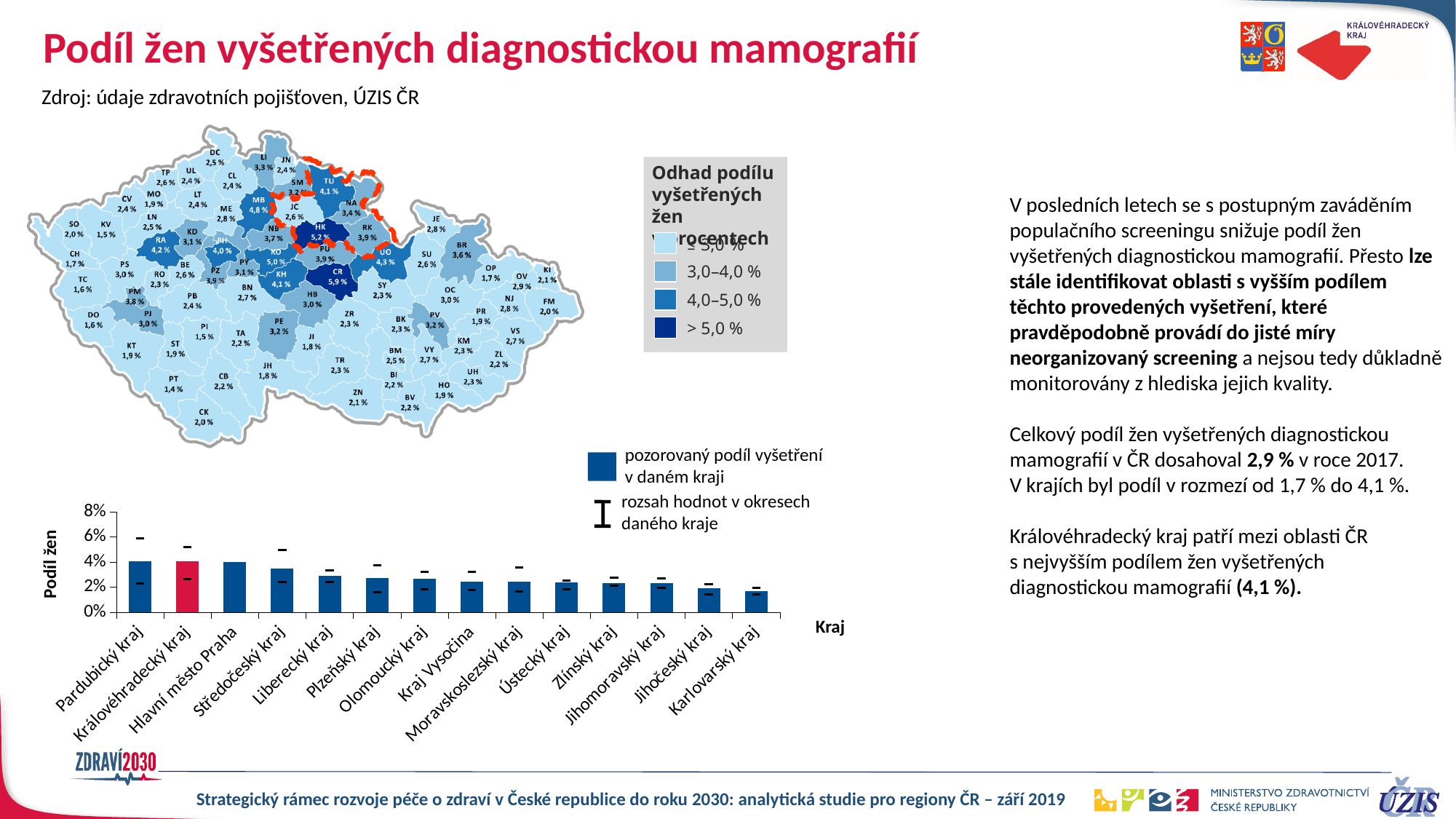
On the map chart, what is the difference between the values for CR and HK? 0,7 % In the bar chart at the bottom left, how many regions (kraje) are plotted on the x axis? 14 On the map chart, what value is shown for the district labelled HK? 5,2 % In the bar chart at the bottom left, which region has the lowest bar? Karlovarský kraj On the map chart, how many colour categories does the legend list? 4 In the bar chart at the bottom left, is the value for Pardubický kraj greater or less than 2%? greater On the map chart, which district has the highest printed value? CR (5,9 %) In the bar chart at the bottom left, do the bar values rise or fall from left to right along the x axis? fall In the bar chart at the bottom left, is the value for Karlovarský kraj greater or less than 2%? less What kind of chart is shown at the bottom left of the slide? bar chart In the bar chart at the bottom left, which bar is higher: Středočeský kraj or Jihočeský kraj? Středočeský kraj In the bar chart at the bottom left, which region's bar is highlighted in red? Královéhradecký kraj